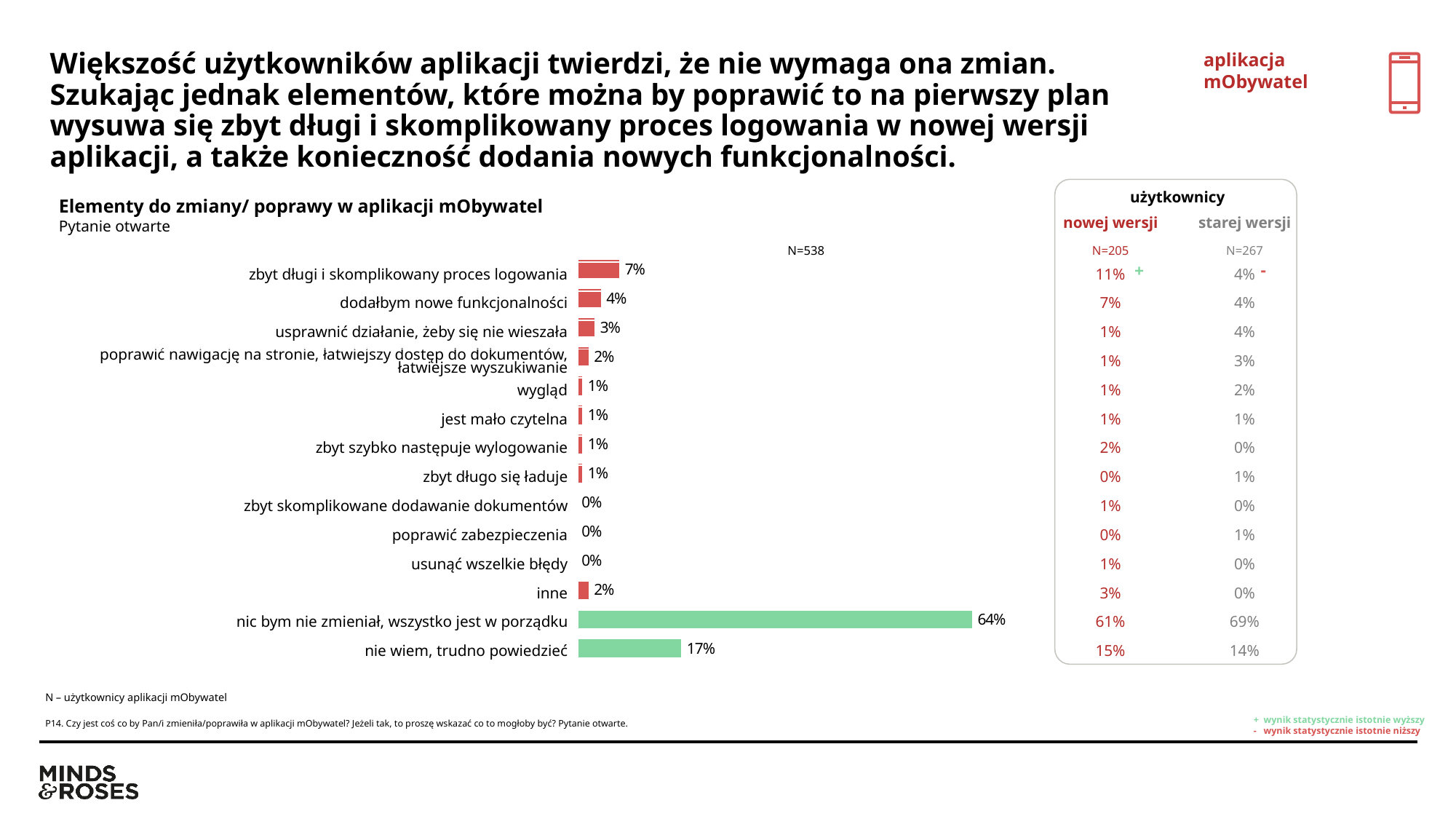
What is the value for "nie wiem, trudno powiedzieć"? 17% What is the difference between "zbyt długi i skomplikowany proces logowania" and "dodałbym nowe funkcjonalności"? 3 percentage points How many categories are shown in the chart? 14 Which is larger: "usprawnić działanie, żeby się nie wieszała" or "inne"? usprawnić działanie, żeby się nie wieszała What is the title of the chart? Elementy do zmiany/ poprawy w aplikacji mObywatel What is the value for "inne"? 2% What kind of chart is shown on the slide? bar chart What is the value for "dodałbym nowe funkcjonalności"? 4% Which category has the highest value? nic bym nie zmieniał, wszystko jest w porządku What is the difference between "nic bym nie zmieniał, wszystko jest w porządku" and "nie wiem, trudno powiedzieć"? 47 percentage points What is the value for "zbyt długi i skomplikowany proces logowania"? 7% What is the value for "nic bym nie zmieniał, wszystko jest w porządku"? 64%